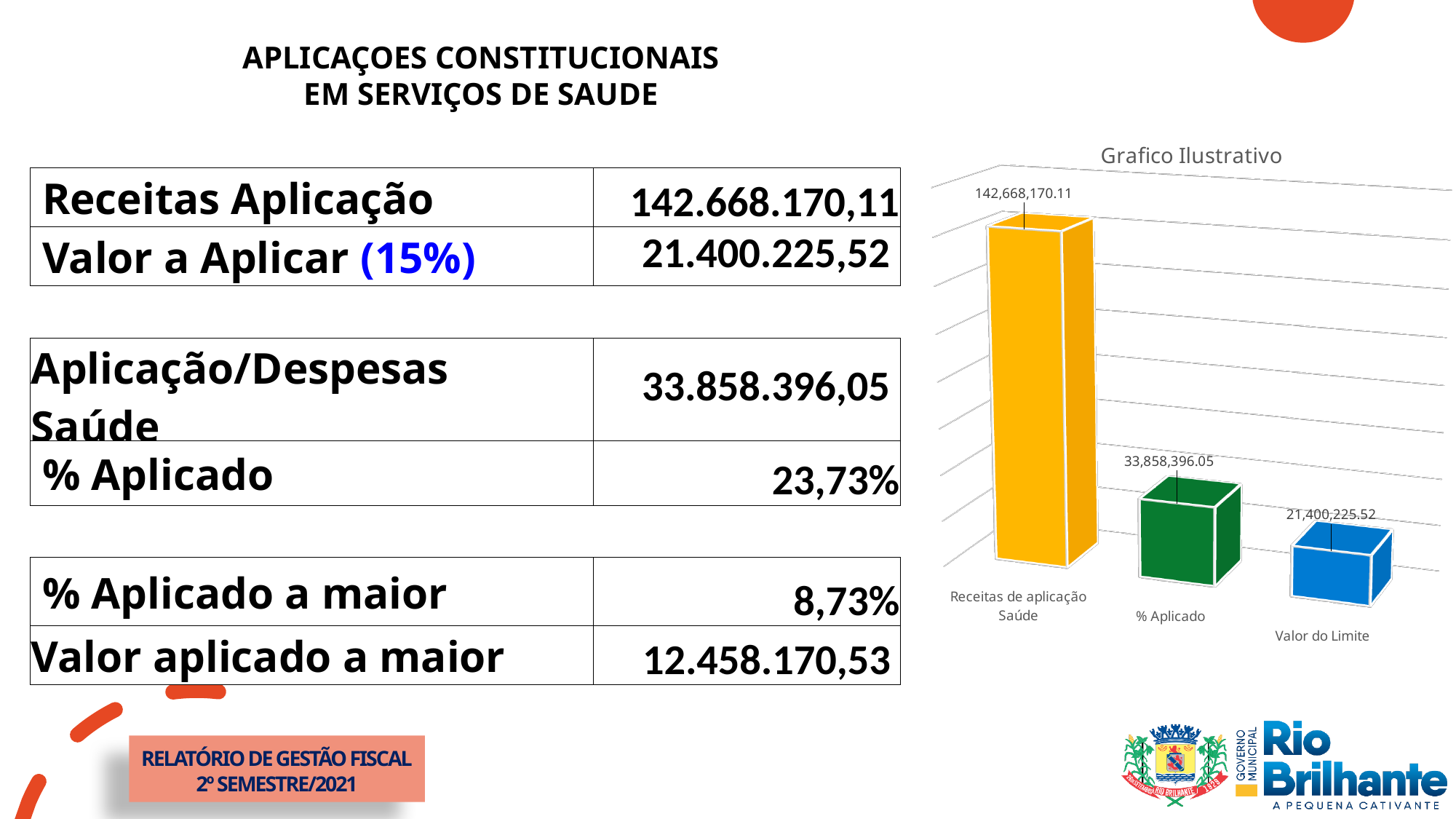
How many bars are plotted in the chart? 3 What kind of chart is shown on the slide? Bar chart Which is larger in the chart, % Aplicado or Valor do Limite? % Aplicado What is the title of the chart? Grafico Ilustrativo What is the difference between the values for % Aplicado and Valor do Limite in the chart? 12,458,170.53 What is the value shown for % Aplicado in the chart? 33,858,396.05 What is the difference between the values for Receitas de aplicação Saúde and % Aplicado in the chart? 108,809,774.06 What is the value shown for Valor do Limite in the chart? 21,400,225.52 What colour is the bar for Valor do Limite? Blue What is the value shown for Receitas de aplicação Saúde in the chart? 142,668,170.11 Which category has the highest value in the chart? Receitas de aplicação Saúde Which category has the lowest value in the chart? Valor do Limite